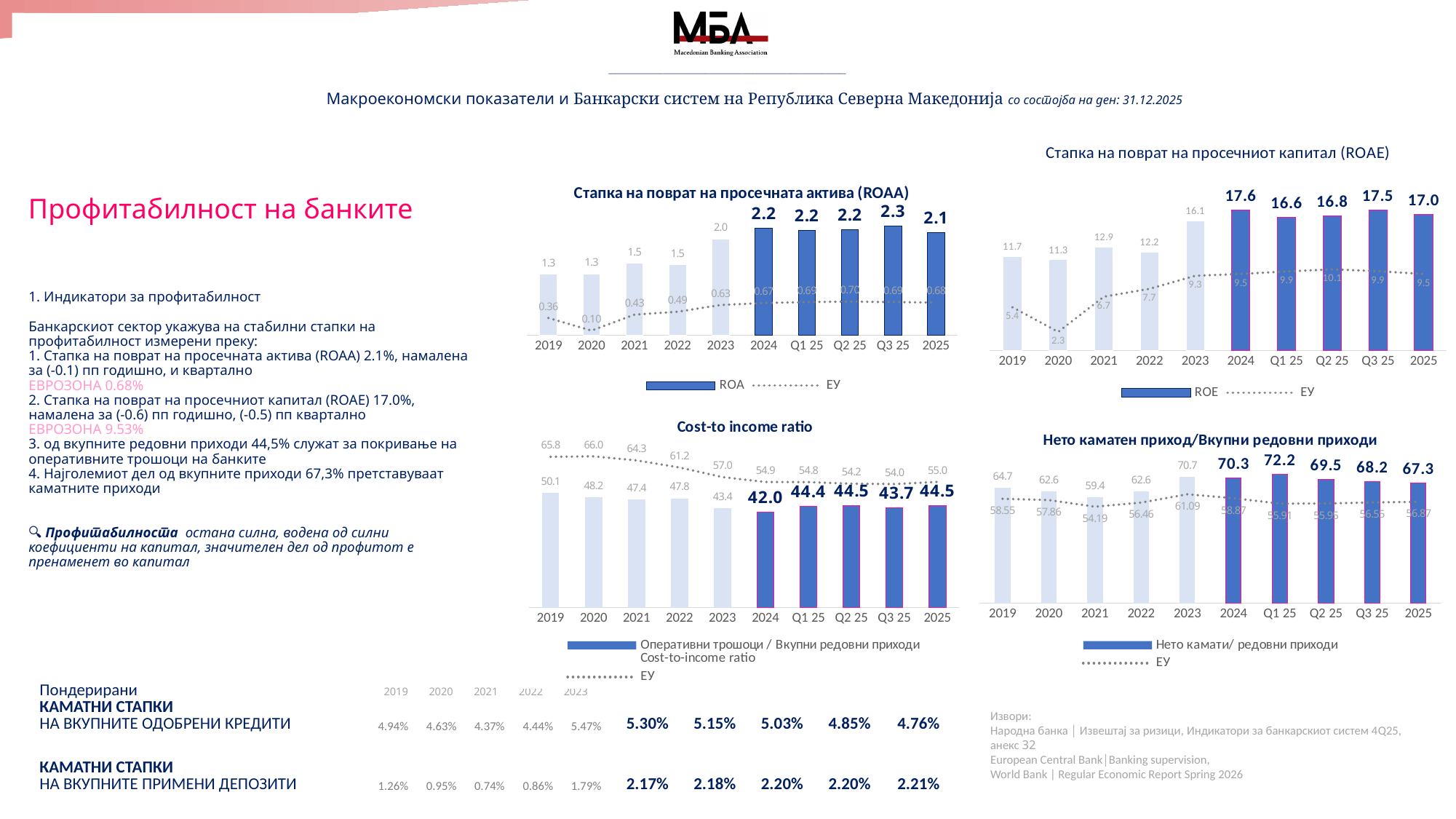
In the ROAA chart (Стапка на поврат на просечната актива), what is the ROA value for 2025? 2.1 In the Cost-to income ratio chart, what is the value for 2024? 42.0 In the ROAA chart, which year or quarter has the highest ROA bar? Q3 25 In the ROAE chart (Стапка на поврат на просечниот капитал), what is the ROE value for 2024? 17.6 In the chart Нето каматен приход/Вкупни редовни приходи, what is the value for Q1 25? 72.2 In the ROAE chart, what is the difference between the ROE value for 2025 and the ROE value for 2019? 5.3 In the Cost-to income ratio chart, which period has the highest bar value? 2019 In the chart Нето каматен приход/Вкупни редовни приходи, how many periods are shown on the x axis? 10 In the Cost-to income ratio chart, is the EU value for 2019 larger or smaller than the EU value for 2025? larger In the ROAA chart, what is the EU (ЕУ) value for 2020? 0.10 In the ROAE chart, which period has the lowest EU (ЕУ) value? 2020 What type of chart is the ROAE chart? Bar chart with a line